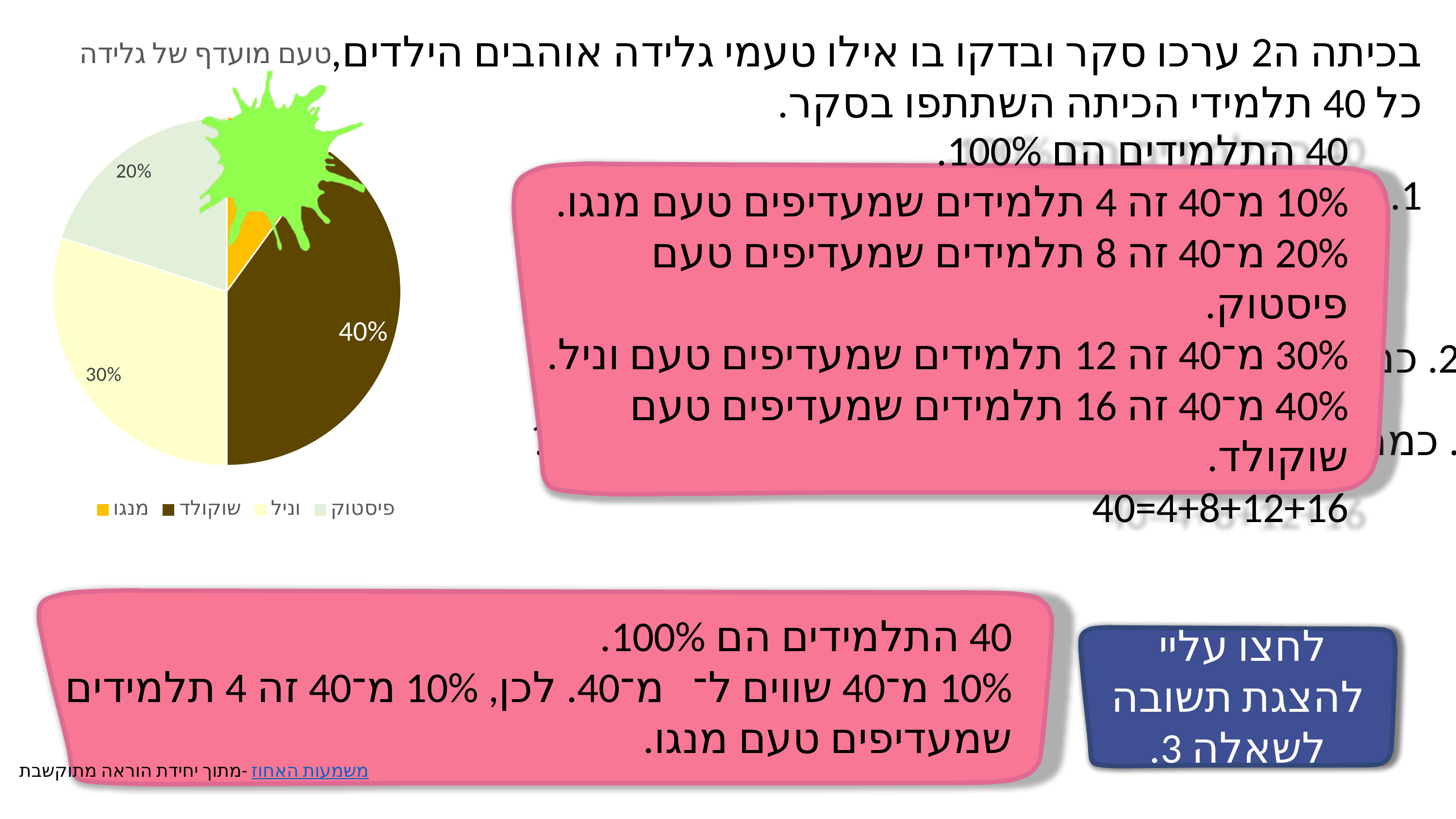
How many percentage points larger is the שוקולד slice than the פיסטוק slice? 20% What percentage of the pie is the שוקולד (chocolate) slice? 40% Which flavor has the largest slice of the pie? שוקולד Which flavor has the smallest slice of the pie? מנגו What kind of chart is shown on the slide? pie chart How many flavors does the legend of the pie chart list? 4 How many percentage points larger is the שוקולד slice than the וניל slice? 10% What percentage of the pie is the פיסטוק (pistachio) slice? 20% What is the title of the pie chart? טעם מועדף של גלידה Which slice is larger, וניל or פיסטוק? וניל What colour is the שוקולד slice in the pie chart? dark brown What percentage of the pie is the וניל (vanilla) slice? 30%